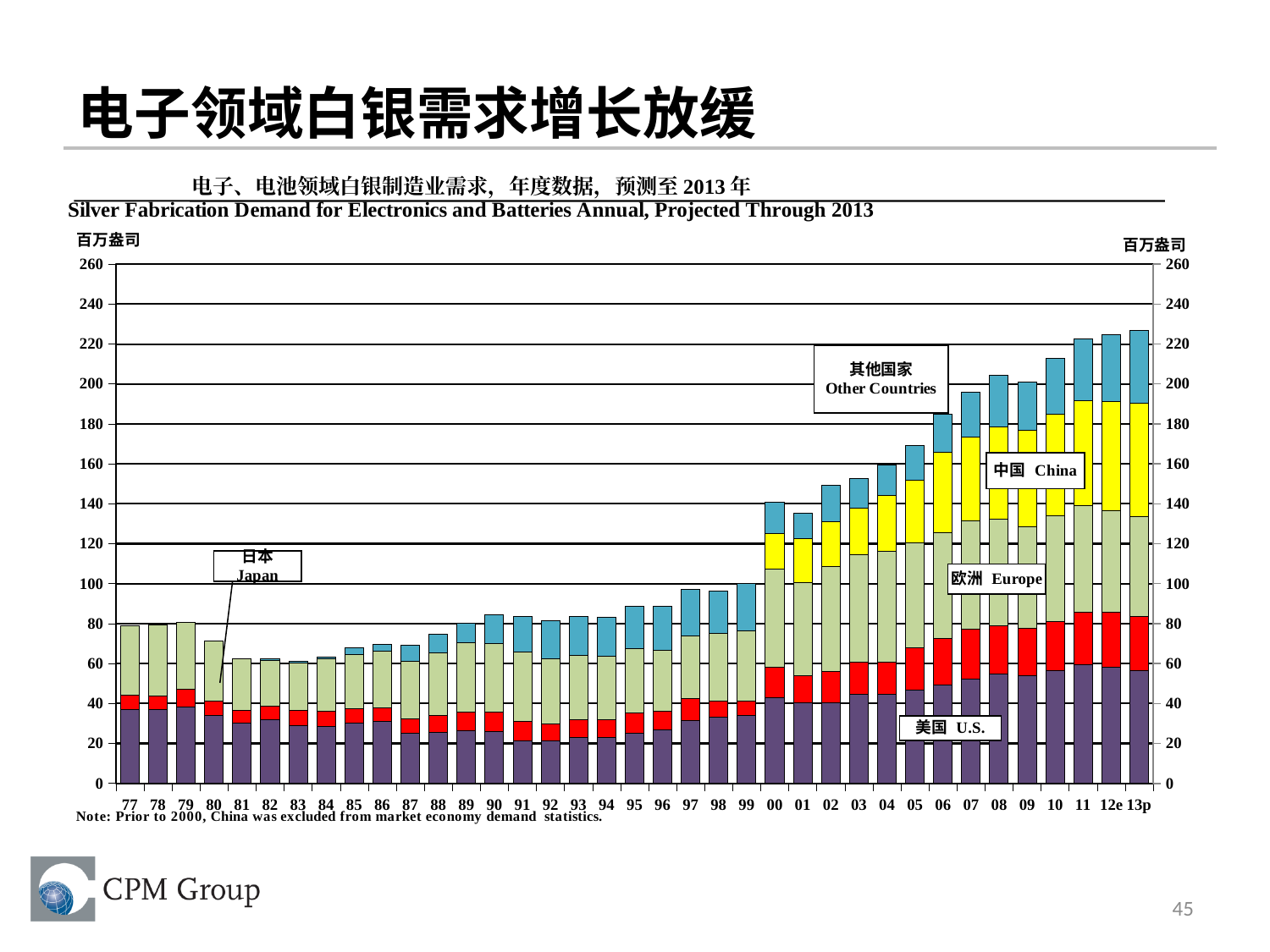
Do total values generally rise or fall from 00 to 13p? rise Is the total bar for 13p greater or less than 220? greater How many years (bars) are plotted on the x axis, from 77 to 13p? 37 Is the total bar for 05 greater or less than 160? greater What unit is shown on the y axis of the chart? 百万盎司 What kind of chart is shown on the slide? Stacked bar chart Is the total bar for 07 greater or less than 200? less How many regional series are labelled on the chart? 5 Which year has the highest total silver fabrication demand? 13p Which year has the larger total demand, 77 or 13p? 13p